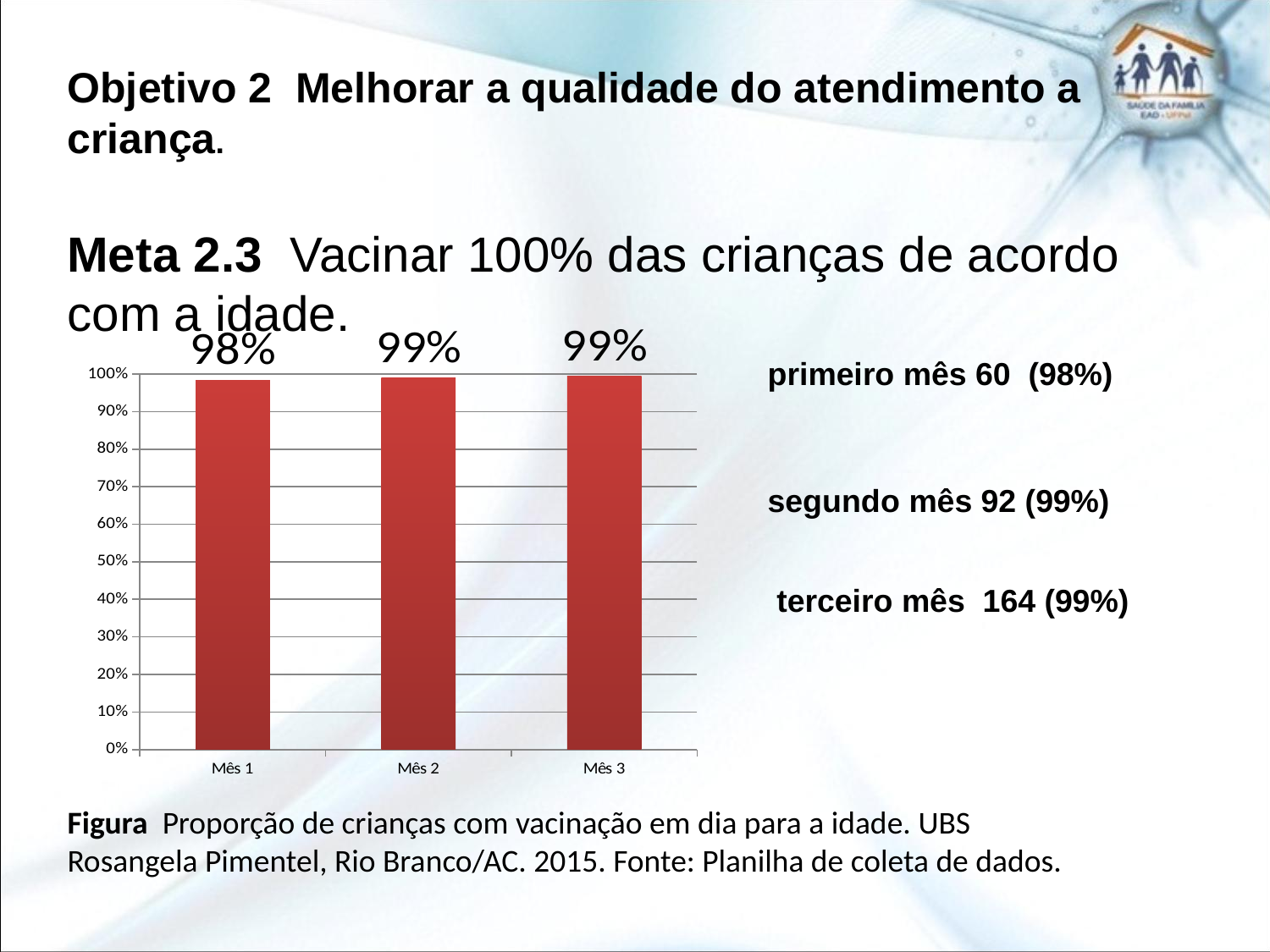
Do the values rise or fall from Mês 1 to Mês 3? rise What colour are the bars? red How many months are shown on the x axis? 3 What is the value for Mês 3? 99% What is the value for Mês 2? 99% Is the value for Mês 1 greater or less than 90%? greater What kind of chart is shown? bar chart What is the difference between the values for Mês 2 and Mês 1? 1% Which is larger, the value for Mês 1 or the value for Mês 2? Mês 2 What is the value for Mês 1? 98% Which month has the lowest value? Mês 1 What is the highest value shown on the y axis? 100%